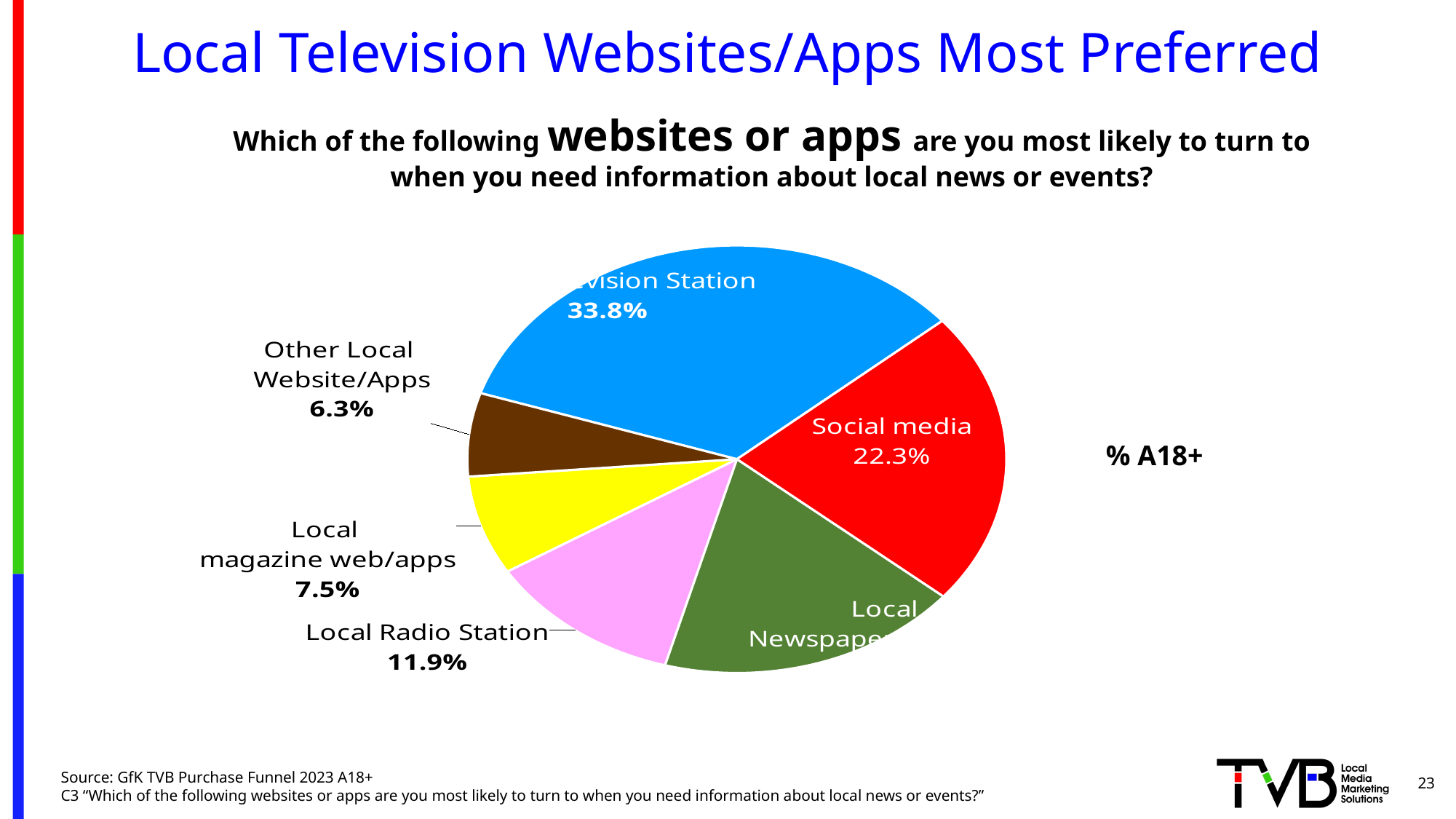
What percentage is shown for Local Radio Station? 11.9% Which slice of the pie chart is the largest? Television Station (33.8%) Which slice of the pie chart is the smallest? Other Local Website/Apps (6.3%) Which is larger, the Local Newspaper slice or the Local Radio Station slice? Local Newspaper What colour is the Social media slice? Red What is the difference in percentage points between the television station slice and Social media? 11.5 How many slices does the pie chart have? 6 What percentage is shown for Local magazine web/apps? 7.5% What kind of chart is shown on the slide? Pie chart What percentage is shown for the television station slice? 33.8% What percentage is shown for Other Local Website/Apps? 6.3% What percentage is shown for Social media? 22.3%